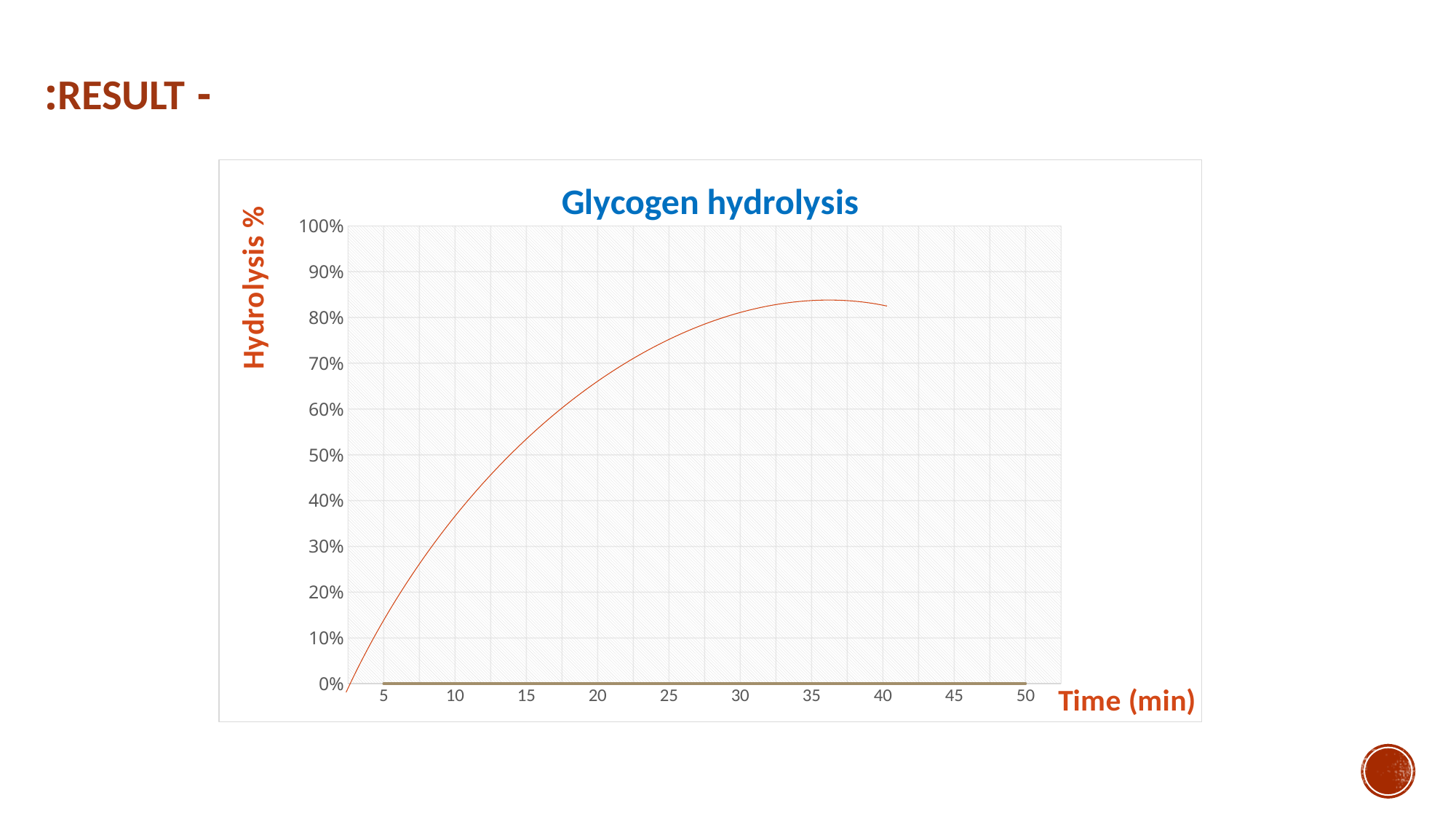
What is the highest value shown on the y axis? 100% Is the hydrolysis value at 20 minutes greater or less than 50%? greater Is the hydrolysis value at 5 minutes greater or less than 30%? less What is the label of the x axis? Time (min) Is the highest point of the hydrolysis curve greater or less than 90%? less How many tick labels are shown on the x axis? 10 Which is larger, the hydrolysis value at 15 minutes or at 35 minutes? 35 minutes What kind of chart is shown on the slide? line chart Does the hydrolysis curve rise or fall between 5 and 30 minutes? rise What is the title of the chart? Glycogen hydrolysis